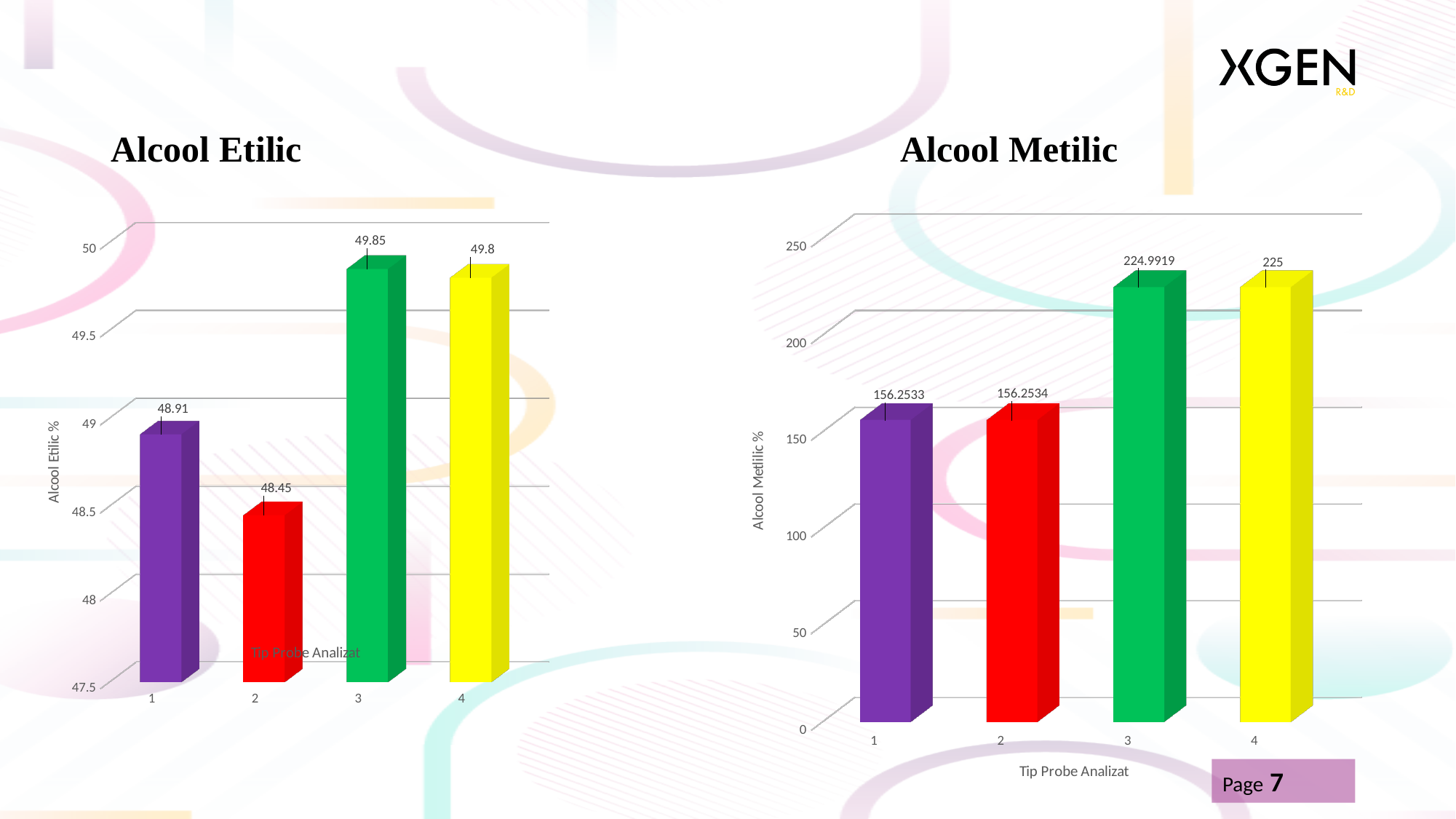
In the Alcool Metilic chart, what is the value for category 4? 225 In the Alcool Etilic chart, what is the value for category 2? 48.45 In the Alcool Metilic chart, which is larger, the value for category 1 or the value for category 3? category 3 In the Alcool Metilic chart, what is the value for category 3? 224.9919 What is the x-axis title of the Alcool Metilic chart? Tip Probe Analizat In the Alcool Metilic chart, is the value for category 2 greater or less than 200? less In the Alcool Etilic chart, which category has the lowest value? 2 In the Alcool Etilic chart, what is the value for category 1? 48.91 In the Alcool Etilic chart, what is the difference between the values for category 1 and category 2? 0.46 What kind of chart is the Alcool Metilic chart? bar chart In the Alcool Etilic chart, is the value for category 3 greater or less than 49.5? greater In the Alcool Etilic chart, how many categories are shown on the x axis? 4